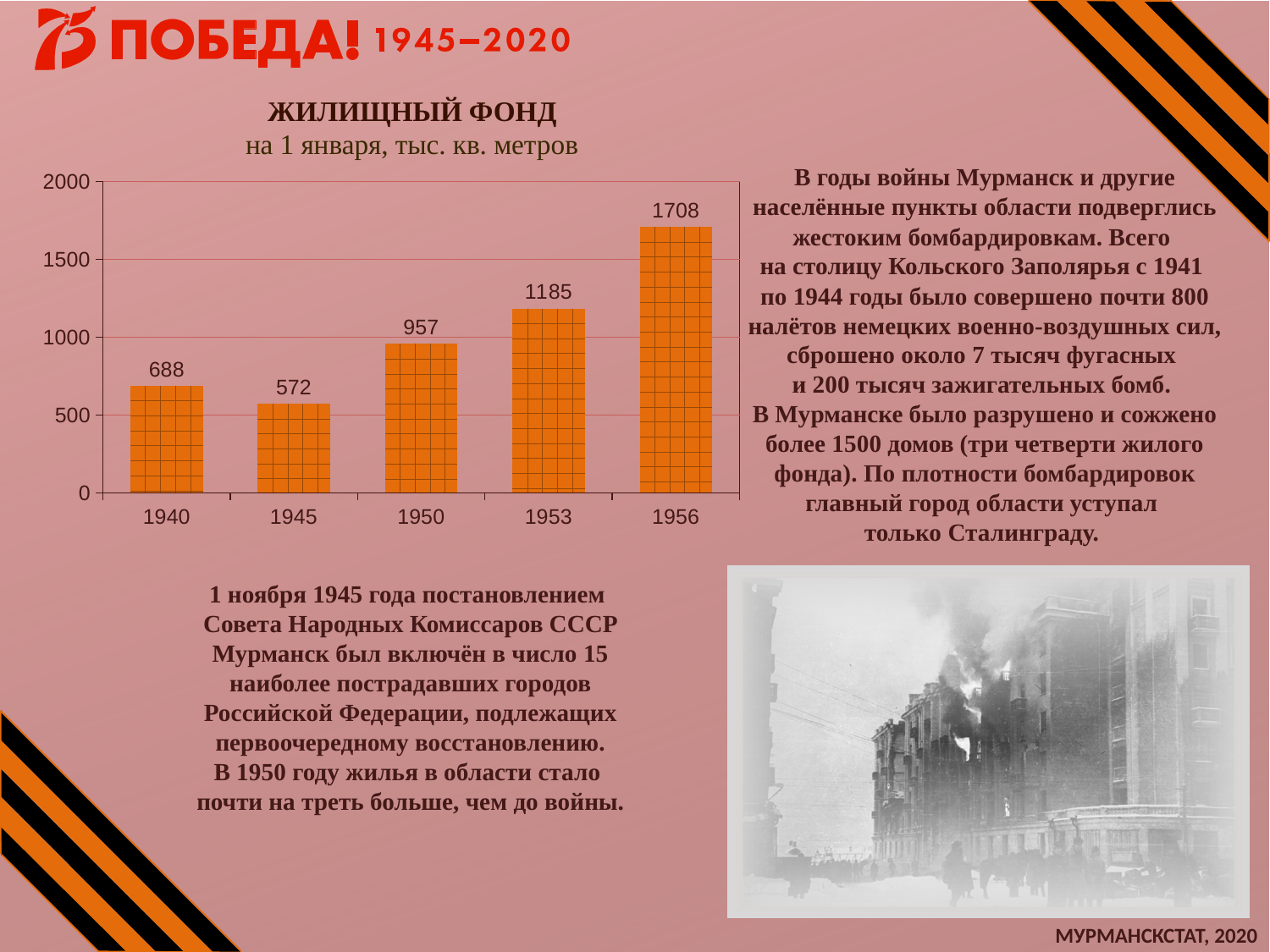
Is the value for 1953 greater or less than 1000? greater What is the housing stock value for 1956? 1708 What is the difference between the values for 1956 and 1953? 523 Which is larger, the value for 1950 or the value for 1940? 1950 What is the value shown for 1950? 957 What is the difference between the values for 1940 and 1945? 116 What is the title of the chart? ЖИЛИЩНЫЙ ФОНД What kind of chart is shown on the slide? bar chart Which year has the lowest housing stock value? 1945 How many years are shown on the x axis of the chart? 5 Which year has the highest housing stock value? 1956 What is the housing stock value for 1940? 688